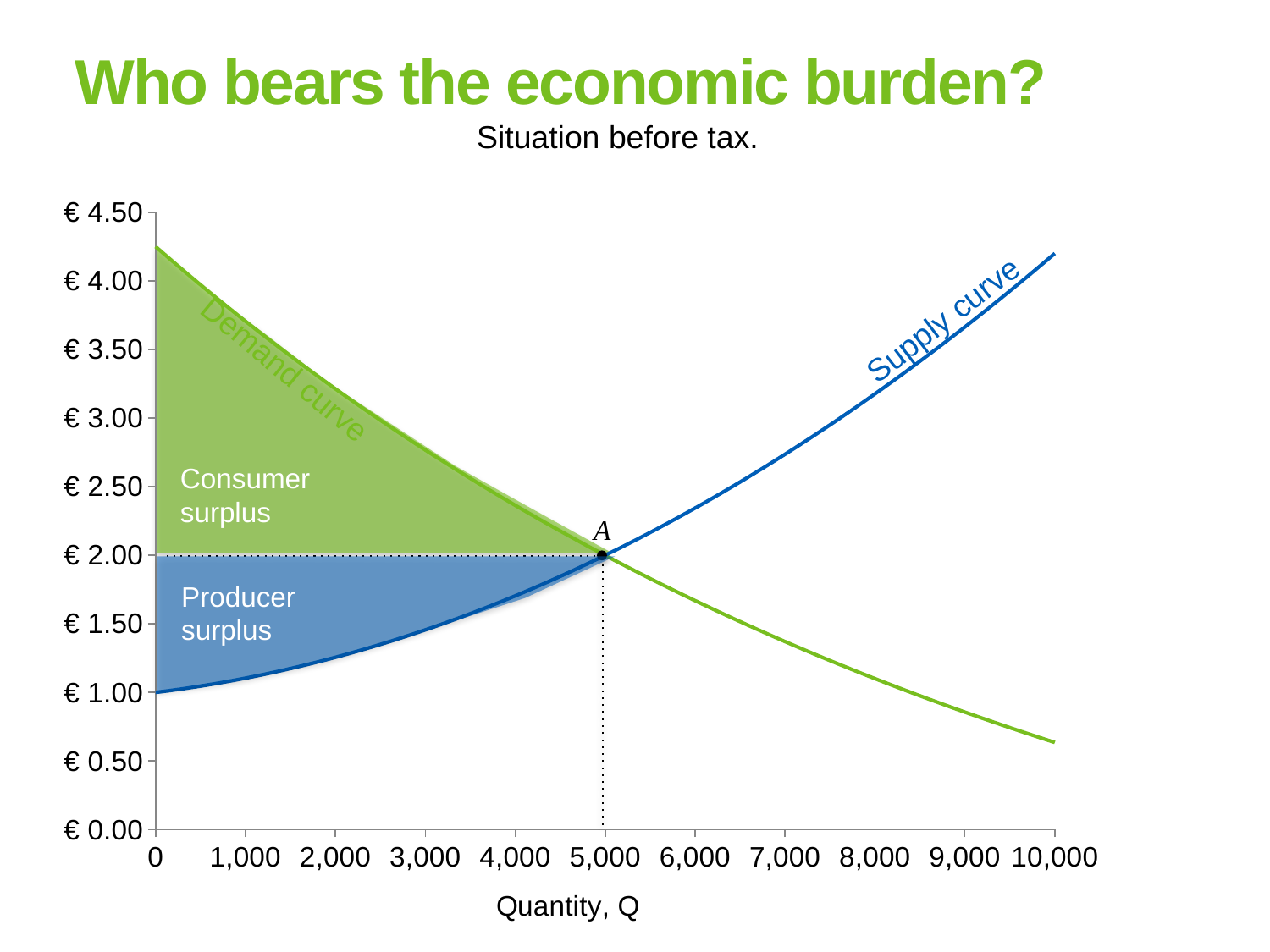
What is the price on the supply curve at a quantity of 0? € 1.00 Does the supply curve rise or fall as quantity increases? rise Is the price on the supply curve at a quantity of 10,000 greater or less than € 4.00? greater What kind of chart is shown on the slide? line chart Is the price on the demand curve at a quantity of 10,000 greater or less than € 1.00? less At a quantity of 8,000, which curve shows the higher price, the supply curve or the demand curve? Supply curve What is the label of the x axis? Quantity, Q Which shaded area lies above the € 2.00 price line, consumer surplus or producer surplus? Consumer surplus What is the price at the equilibrium point A? € 2.00 What is the quantity at the equilibrium point A? 5,000 Does the demand curve rise or fall as quantity increases? fall Is the price on the demand curve at a quantity of 0 greater or less than € 4.00? greater